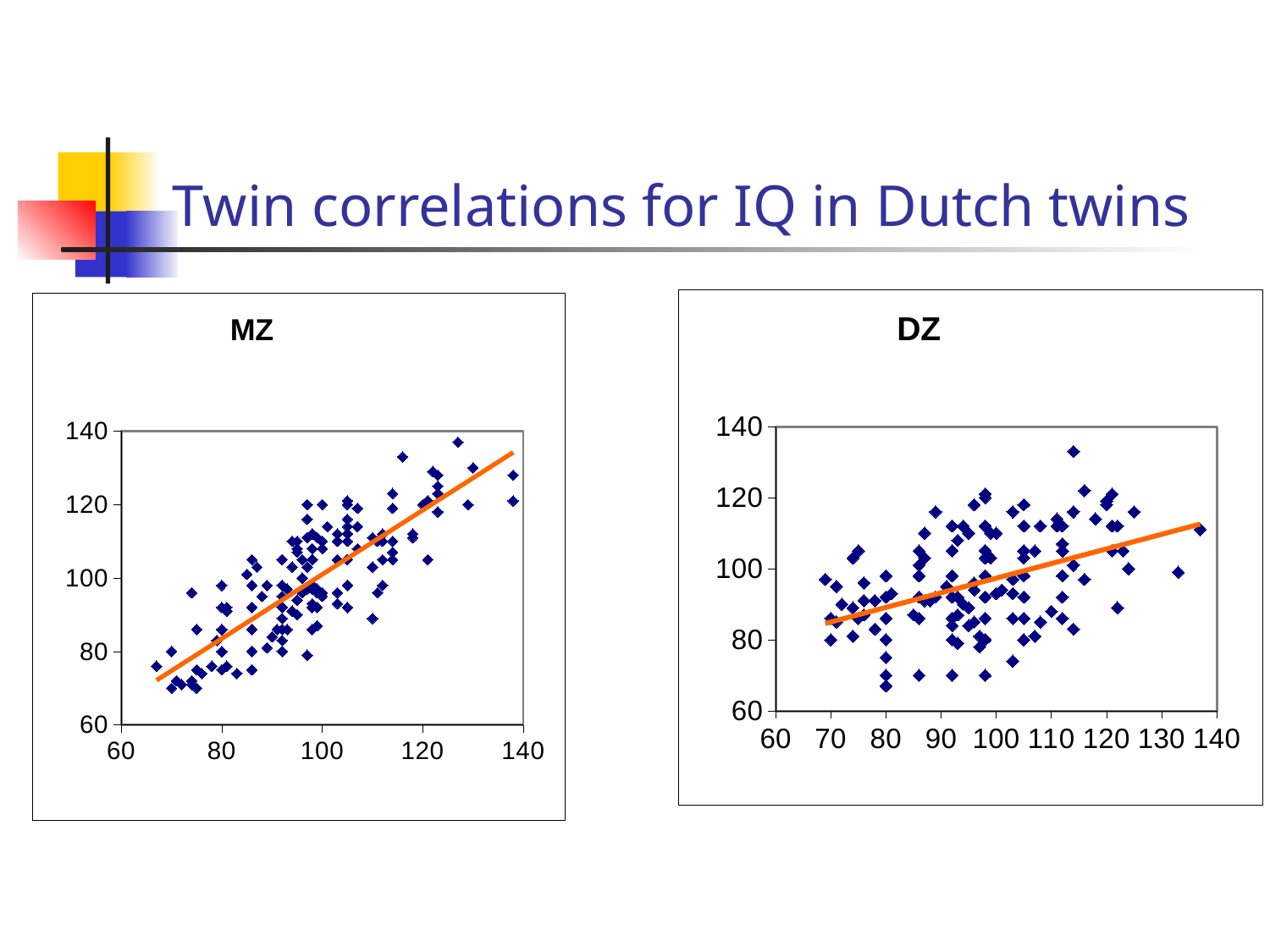
In the MZ chart, is the trend line's value at x = 120 greater or less than 100? greater In the MZ chart, is the trend line's value at x = 80 greater or less than 100? less What kind of chart is the MZ chart on the left? scatter chart In the DZ chart, is the trend line's value at x = 70 greater or less than 100? less How many charts are shown on the slide? 2 What are the titles of the two charts on the slide? MZ and DZ What colour is the trend line in the MZ chart? orange Which chart has the steeper trend line, MZ or DZ? MZ In which chart are the points more tightly clustered around the trend line, MZ or DZ? MZ In the MZ chart, does the trend line rise or fall as the x-axis value increases? rise What kind of chart is the DZ chart on the right? scatter chart In the DZ chart, does the trend line rise or fall as the x-axis value increases? rise